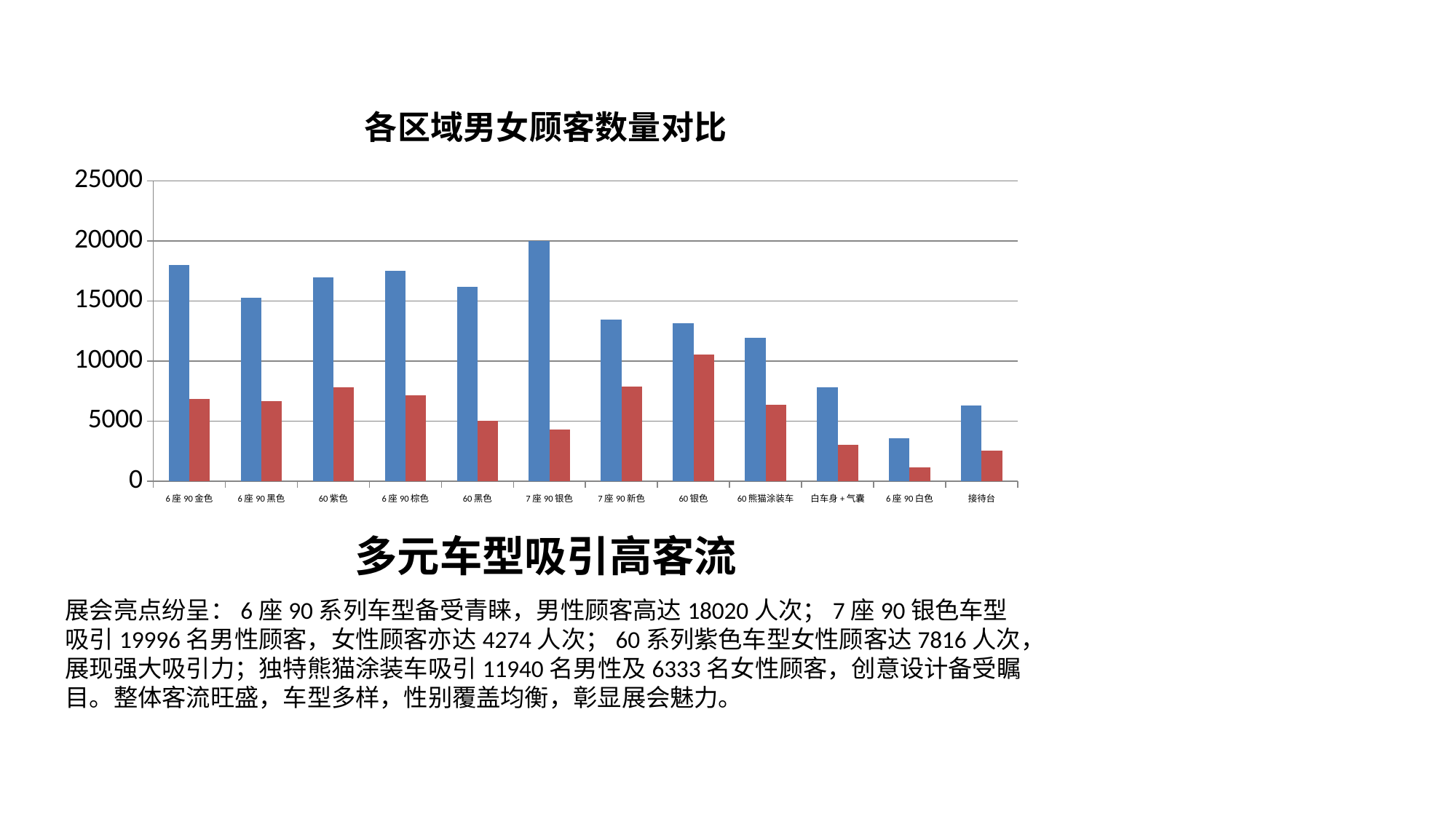
How many series (bar colours) are plotted for each category in the chart? 2 Is the blue bar for 接待台 greater or less than 5000? greater Which category has the tallest blue bar in the chart? 7座90银色 Which category has the shortest blue bar in the chart? 6座90白色 Which has the taller blue bar, 6座90金色 or 6座90黑色? 6座90金色 How many categories are shown along the x axis of the chart? 12 Which category has the shortest red bar in the chart? 6座90白色 Is the blue bar for 6座90金色 greater or less than 15000? greater What kind of chart is shown on the slide? bar chart What is the title of the chart? 各区域男女顾客数量对比 Which category has the tallest red bar in the chart? 60银色 Is the red bar for 7座90银色 greater or less than 5000? less